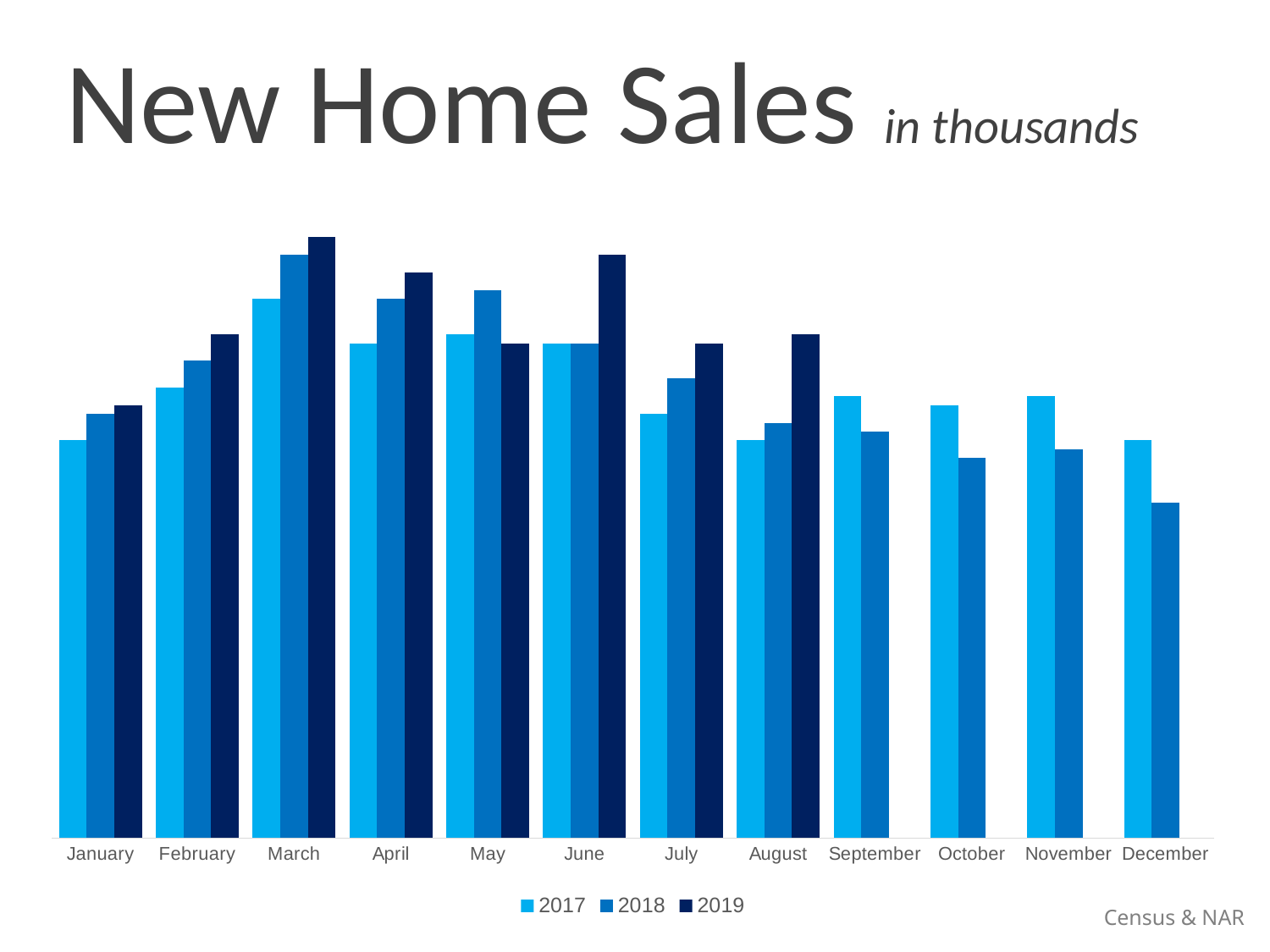
For May, which year has the larger value, 2018 or 2019? 2018 How many months are shown along the x axis? 12 In which month is the 2019 bar the highest? March For October, which year has the larger value, 2017 or 2018? 2017 In which month is the 2017 bar the highest? March What kind of chart is shown on the slide? bar chart In what units are the values on the chart expressed, according to the title? in thousands In which month is the 2018 bar the lowest? December Do the 2018 values rise or fall from September to December? fall How many series does the legend list? 3 For June, which year has the larger value, 2018 or 2019? 2019